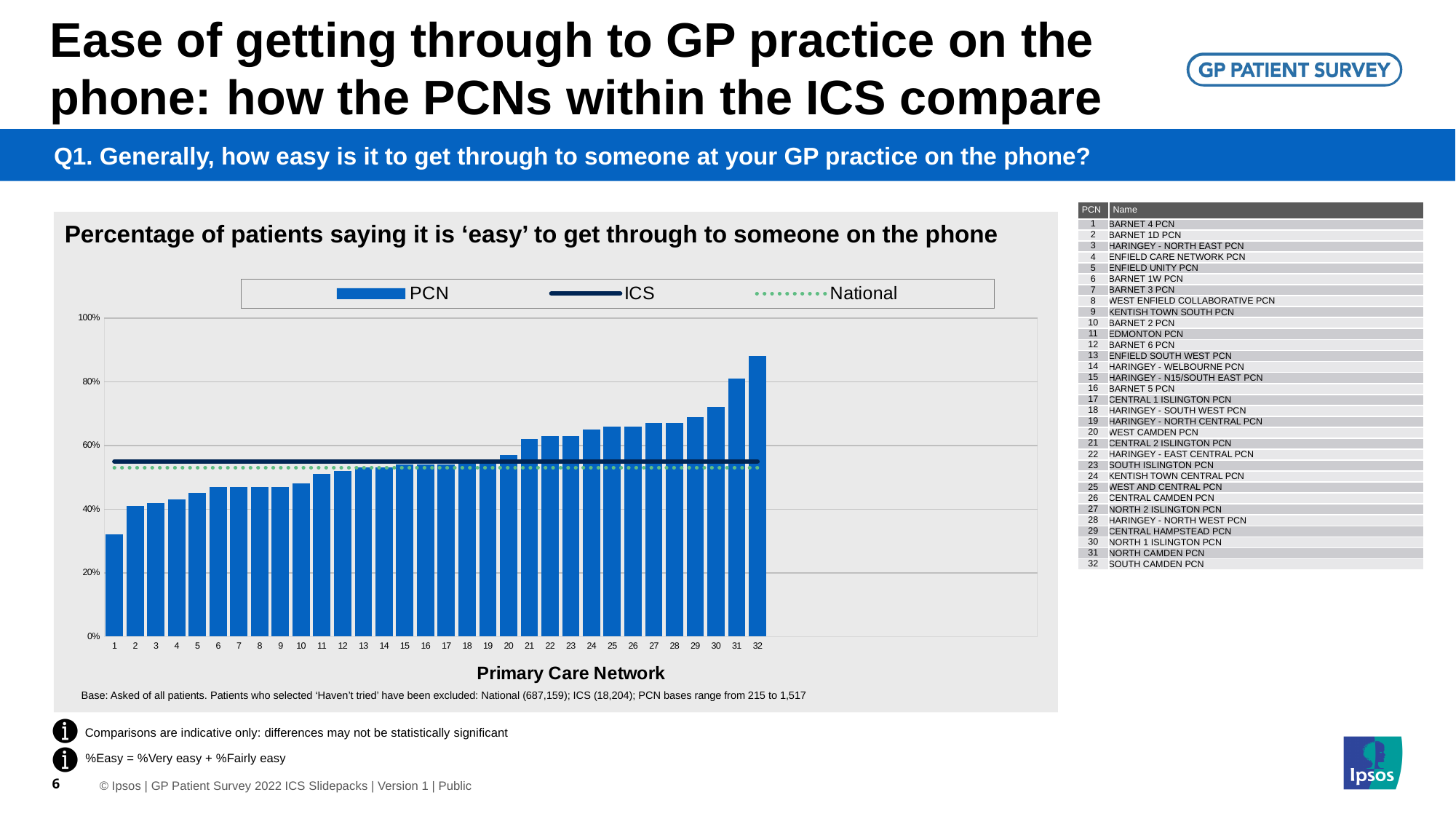
What kind of chart is used to show the percentage of patients saying it is 'easy' to get through on the phone? Bar chart Which PCN has the highest percentage of patients saying it is 'easy' to get through on the phone? 32 Which PCN has the lowest percentage of patients saying it is 'easy' to get through on the phone? 1 Is the value for PCN 30 greater or less than 80%? less How many Primary Care Networks are plotted on the x axis of the chart? 32 How many series does the chart legend list? 3 Is the value for PCN 32 greater or less than 80%? greater Which has a higher value, PCN 32 or PCN 1? PCN 32 Is the value for PCN 11 greater or less than 60%? less Do the PCN bar values rise or fall moving from PCN 1 to PCN 32 along the x axis? Rise What is the title of the x axis of the chart? Primary Care Network